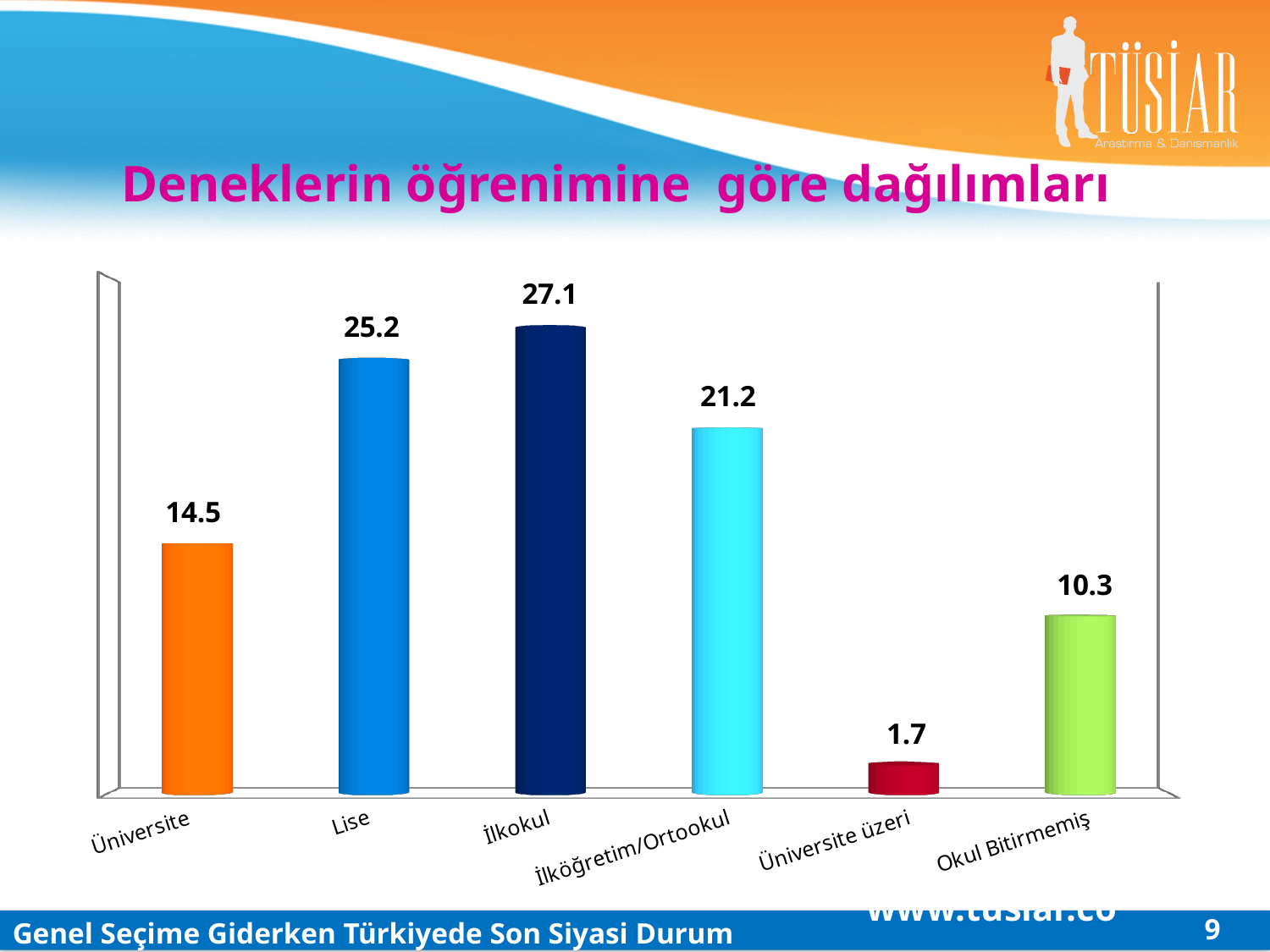
What is the value for Üniversite üzeri? 1.7 What is the difference between the values for Üniversite and Okul Bitirmemiş? 4.2 How many categories are shown in the chart? 6 What is the title of the slide? Deneklerin öğrenimine göre dağılımları Which is larger, the value for İlköğretim/Ortookul or the value for Üniversite? İlköğretim/Ortookul What is the value for Okul Bitirmemiş? 10.3 Which category has the lowest value? Üniversite üzeri Which category has the highest value? İlkokul What colour is the bar for Üniversite? orange What kind of chart is shown on the slide? bar chart What is the value for Lise? 25.2 What is the difference between the values for İlkokul and Lise? 1.9